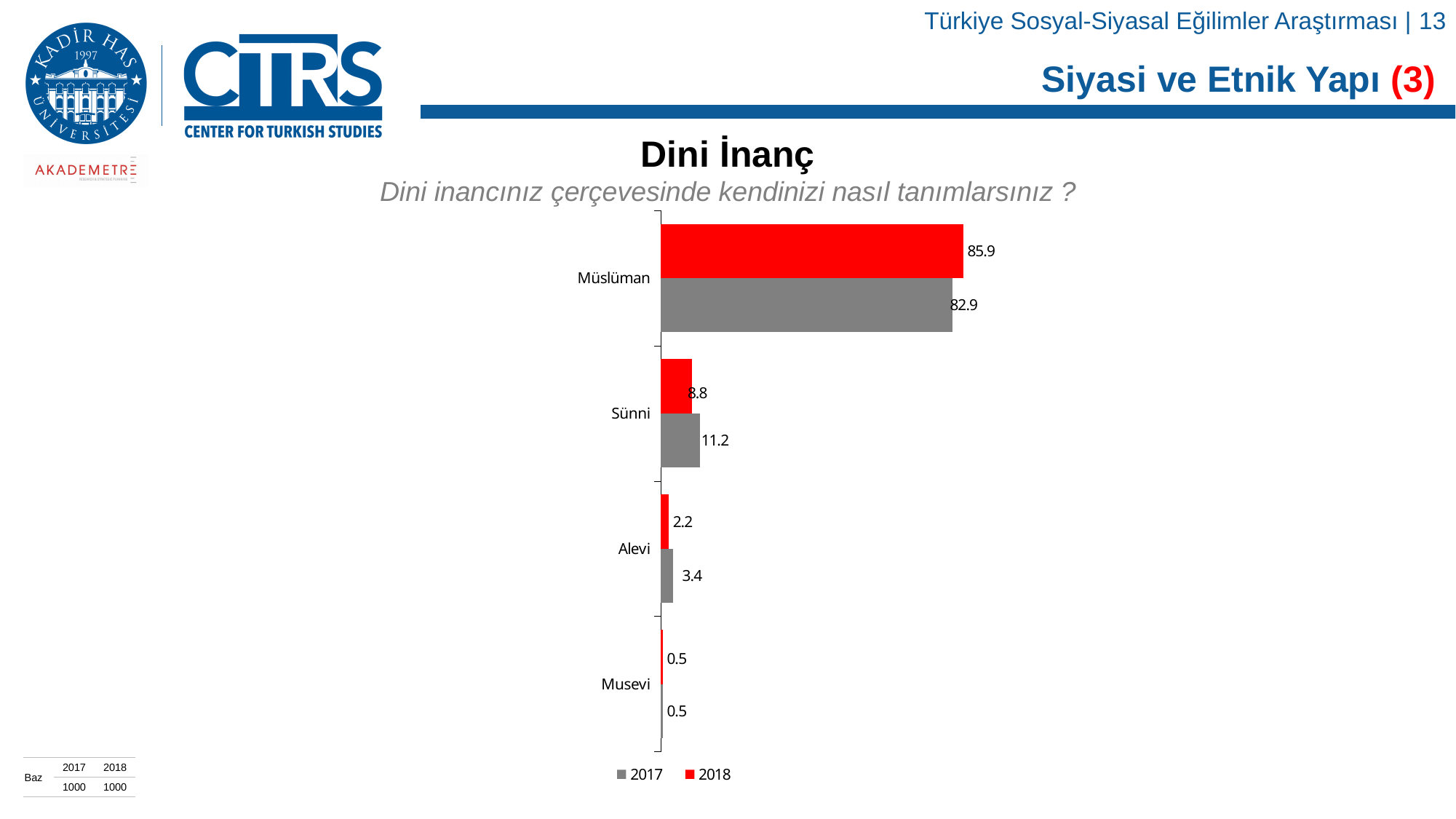
How many series does the legend list? 2 What is the difference between the 2017 and 2018 values for Sünni? 2.4 How many categories are shown on the chart? 4 Which category has the highest 2018 value? Müslüman What is the 2018 value for Alevi? 2.2 For Alevi, which year has the larger value, 2017 or 2018? 2017 What kind of chart is shown on the slide? Bar chart What is the difference between the 2018 and 2017 values for Müslüman? 3.0 What is the 2017 value for Sünni? 11.2 What is the 2018 value for Müslüman? 85.9 Which category has the lowest 2017 value? Musevi What is the 2017 value for Musevi? 0.5